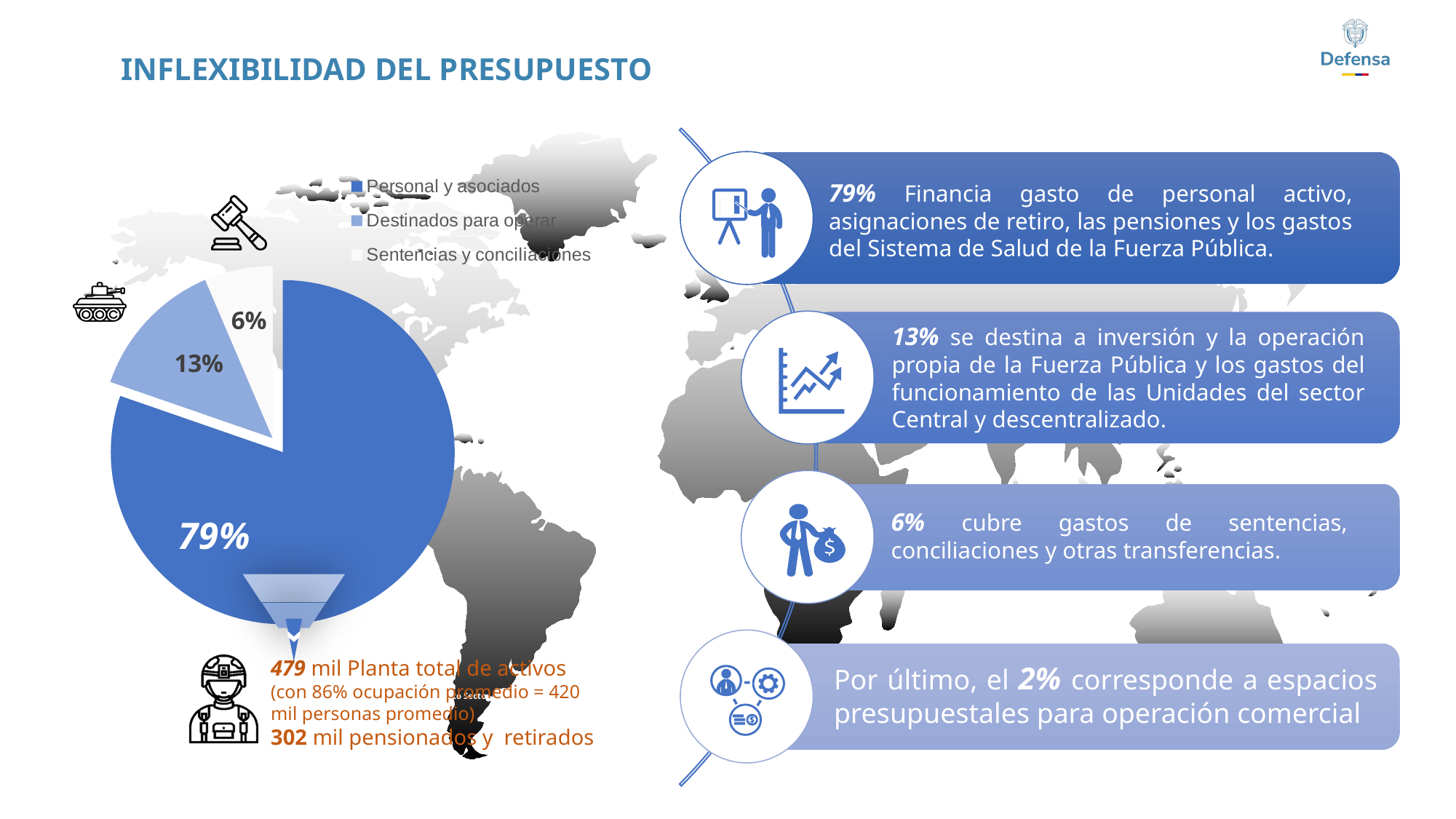
What is the difference in percentage points between "Personal y asociados" and "Destinados para operar"? 66 Which legend entry is shown in the darkest blue colour? Personal y asociados Which is larger, the slice for "Destinados para operar" or the slice for "Sentencias y conciliaciones"? Destinados para operar How many slices does the pie chart have? 3 What share of the pie does "Sentencias y conciliaciones" represent? 6% Which category has the largest slice of the pie? Personal y asociados How many entries does the legend of the pie chart list? 3 What share of the pie does "Destinados para operar" represent? 13% Which category has the smallest slice of the pie? Sentencias y conciliaciones What share of the pie does "Personal y asociados" represent? 79% What is the difference in percentage points between "Destinados para operar" and "Sentencias y conciliaciones"? 7 What kind of chart is shown on the slide? Pie chart